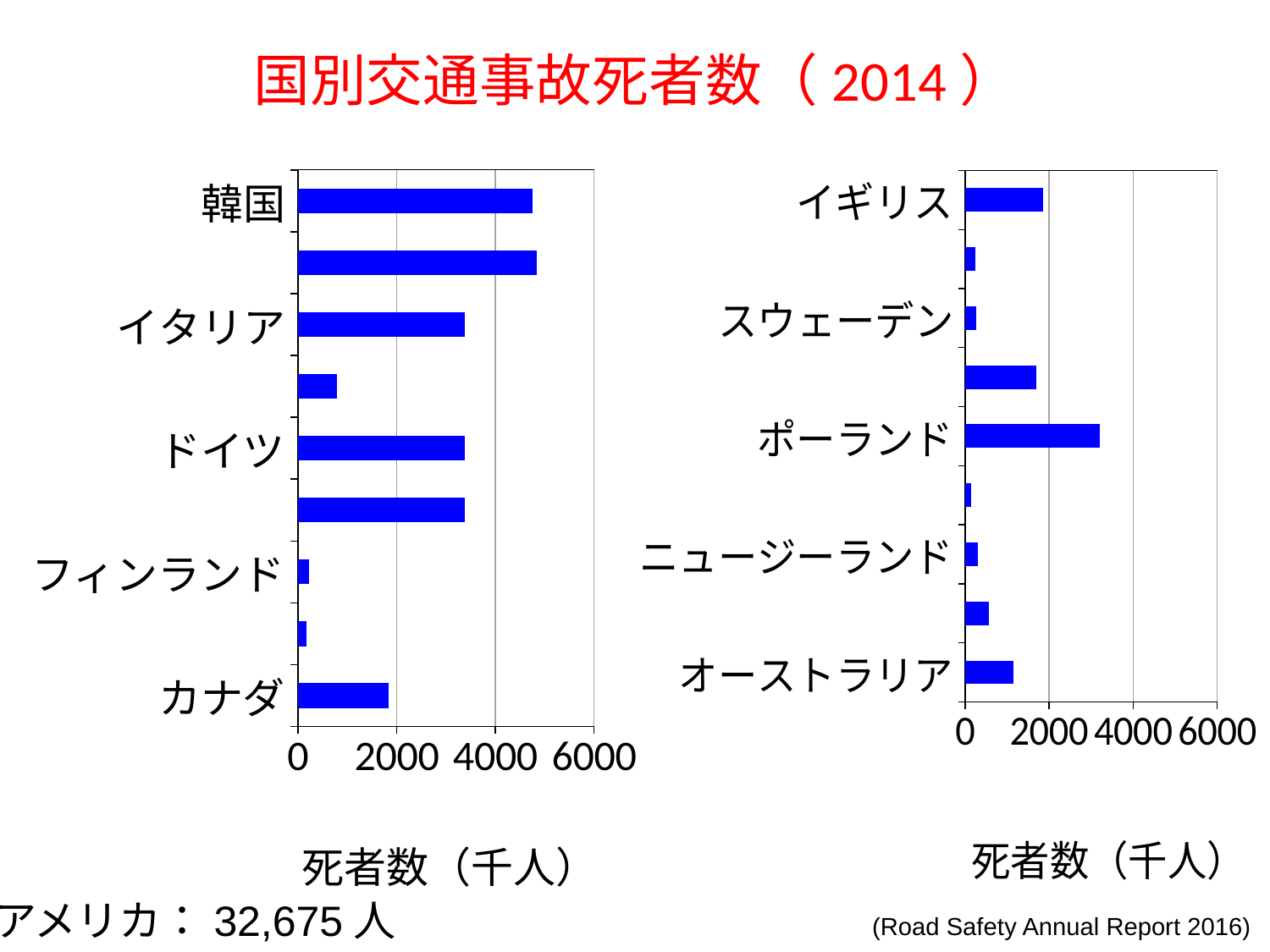
In the right chart, which category has the highest value? ポーランド In the left chart, is the value for フィンランド greater or less than 2000? less In the right chart, is the value for ポーランド greater or less than 2000? greater What is the title shown above the charts on the slide? 国別交通事故死者数（2014） In the right chart, which is larger, the value for オーストラリア or the value for スウェーデン? オーストラリア How many bars are plotted in the right chart? 9 In the left chart, is the value for 韓国 greater or less than 4000? greater In the left chart, which is larger, the value for 韓国 or the value for イタリア? 韓国 In the left chart, which is larger, the value for カナダ or the value for フィンランド? カナダ What type of chart is shown on the left side of the slide? bar chart